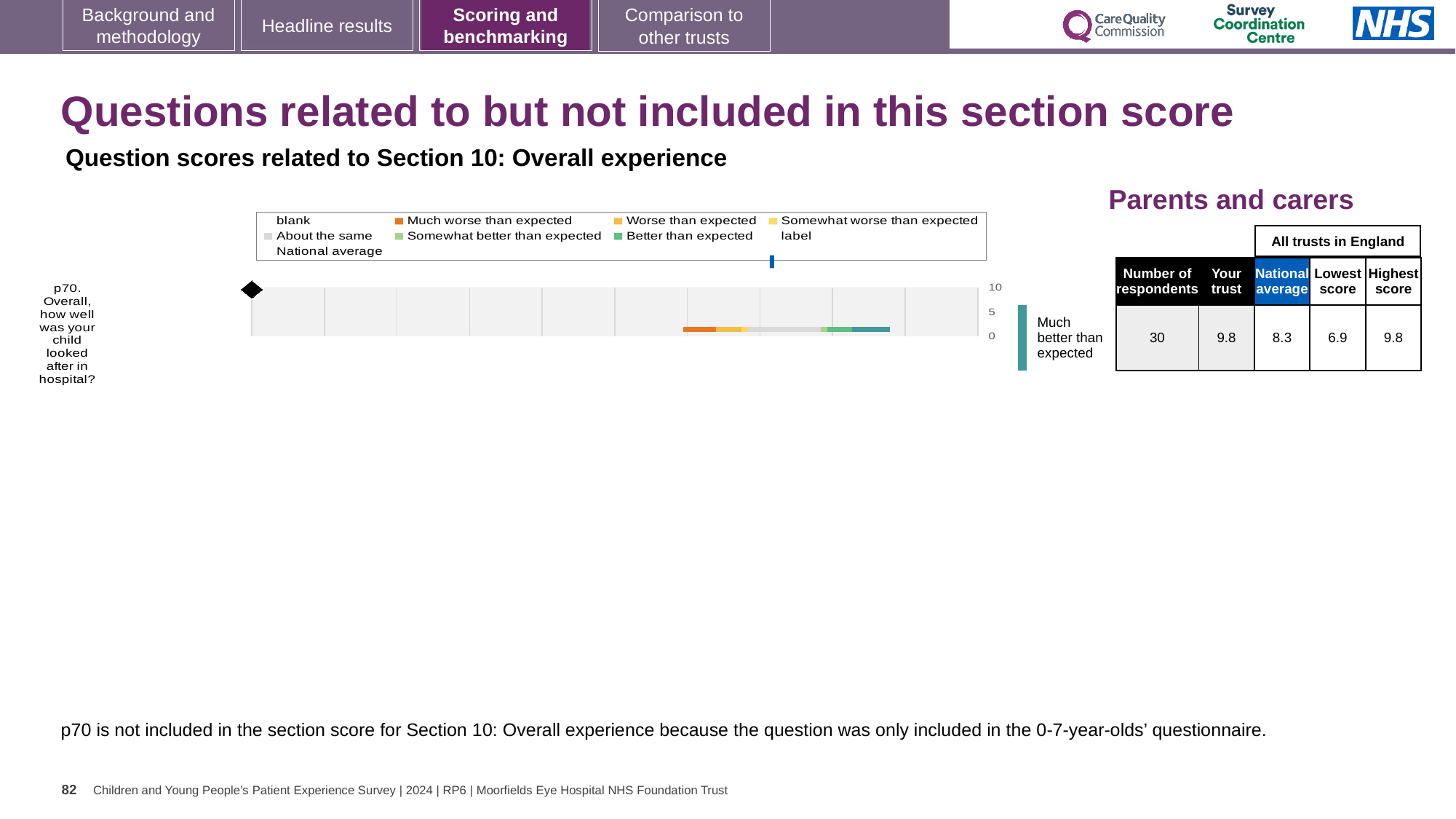
What is the Lowest score among all trusts in England for p70? 6.9 What is the difference between the 'Your trust' score and the National average for p70? 1.5 What is the National average score for p70? 8.3 What kind of chart is used to show the p70 question score? bar chart Which benchmark category is the p70 result labelled with next to the chart? Much better than expected What is the 'Your trust' score for p70 in the Parents and carers table? 9.8 How many respondents answered p70? 30 What is the Highest score among all trusts in England for p70? 9.8 What is the difference between the Highest score and the Lowest score for p70? 2.9 What is the highest value shown on the chart's axis? 10 How many questions are plotted in the chart? 1 Which is larger for p70, the 'Your trust' score or the National average? Your trust